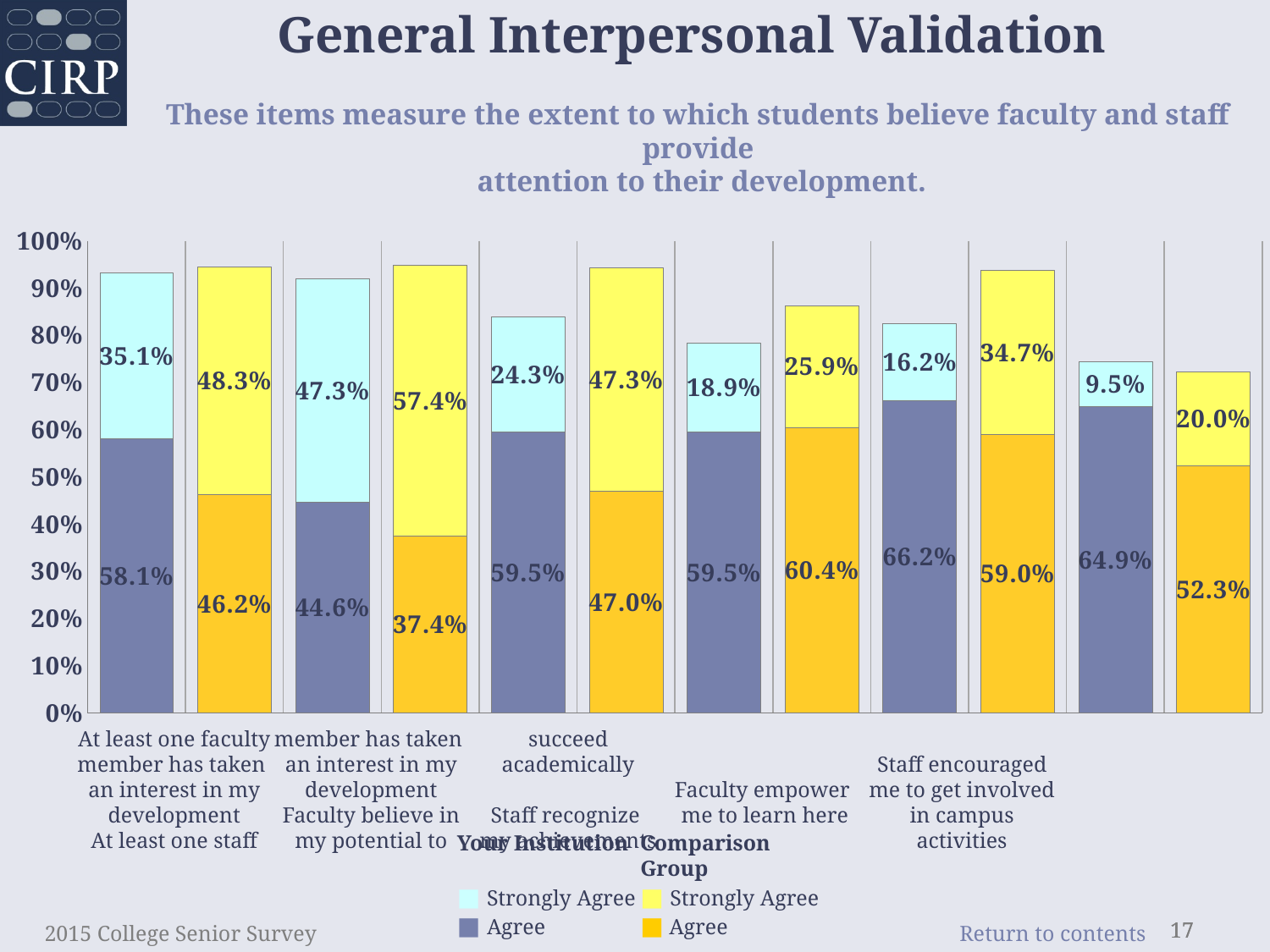
What is the total (Agree plus Strongly Agree) of the Your Institution bar in the leftmost pair? 93.2% What is the Agree value for Your Institution in the first (leftmost) pair of bars, 'At least one faculty member has taken an interest in my development'? 58.1% Which Strongly Agree data label is the lowest on the chart? 9.5% In the rightmost pair of bars, is the Strongly Agree value larger for Your Institution or for the Comparison Group? Comparison Group What is the Agree value for Your Institution in the rightmost pair of bars? 64.9% What kind of chart is shown on the slide? Stacked bar chart Which Agree data label is the highest on the chart? 66.2% What is the Strongly Agree value for the Comparison Group in the second pair of bars from the left? 57.4% What is the title of the chart slide? General Interpersonal Validation What is the difference between the Comparison Group Strongly Agree value (57.4%) and the Your Institution Strongly Agree value (47.3%) in the second pair of bars? 10.1% How many series does the legend list? 4 What is the Strongly Agree value for the Comparison Group in the first (leftmost) pair of bars? 48.3%